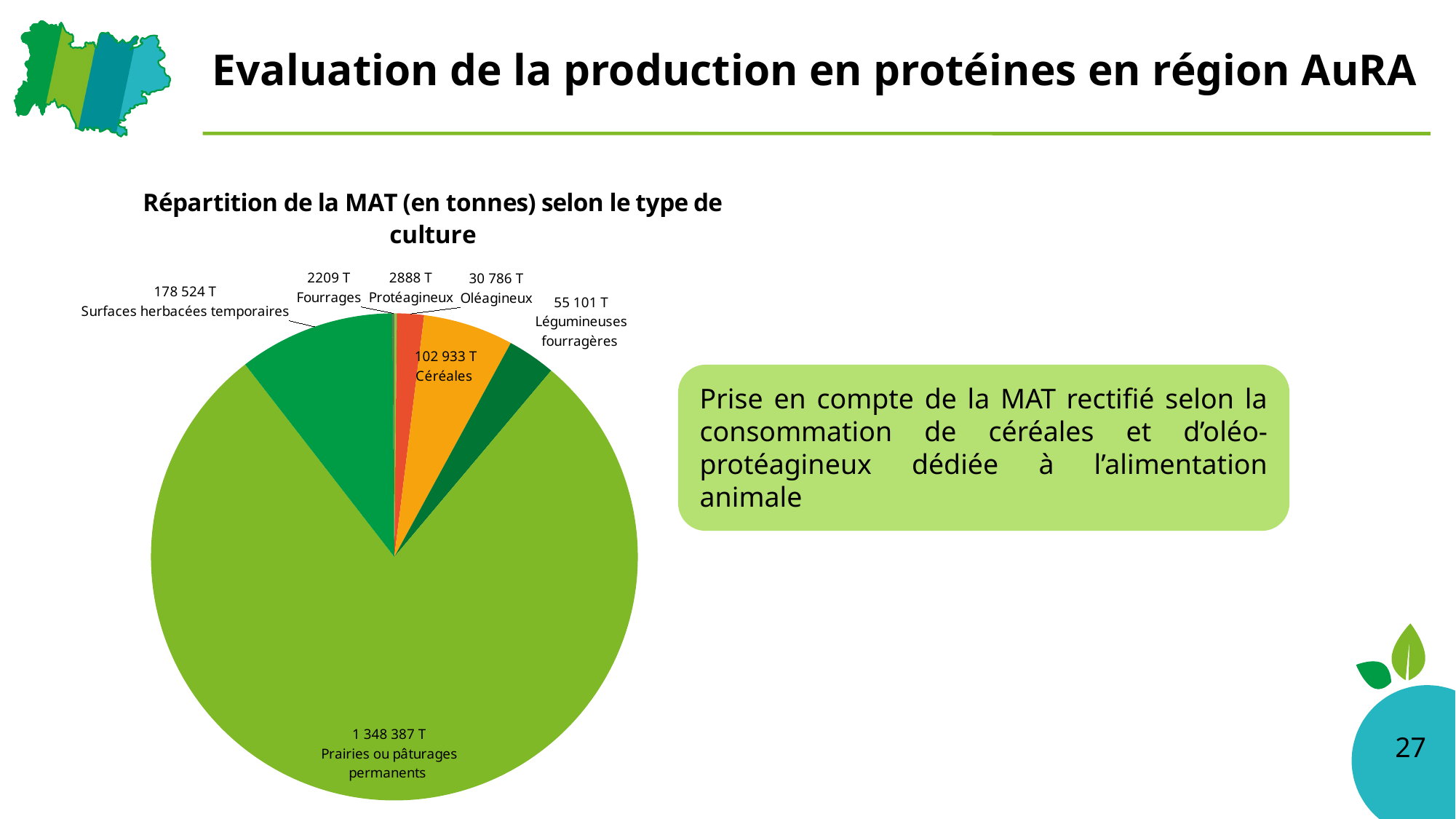
Which category has the smallest value? Fourrages What kind of chart is shown on the slide? pie chart What is the title of the chart? Répartition de la MAT (en tonnes) selon le type de culture What is the difference between Céréales and Légumineuses fourragères? 47 832 T What is the value for Prairies ou pâturages permanents? 1 348 387 T Which category has the largest value? Prairies ou pâturages permanents How many categories (slices) does the pie chart have? 7 What is the value for Légumineuses fourragères? 55 101 T Which is larger, Protéagineux or Fourrages? Protéagineux What is the difference between Surfaces herbacées temporaires and Céréales? 75 591 T What is the value for Oléagineux? 30 786 T What is the value for Céréales? 102 933 T